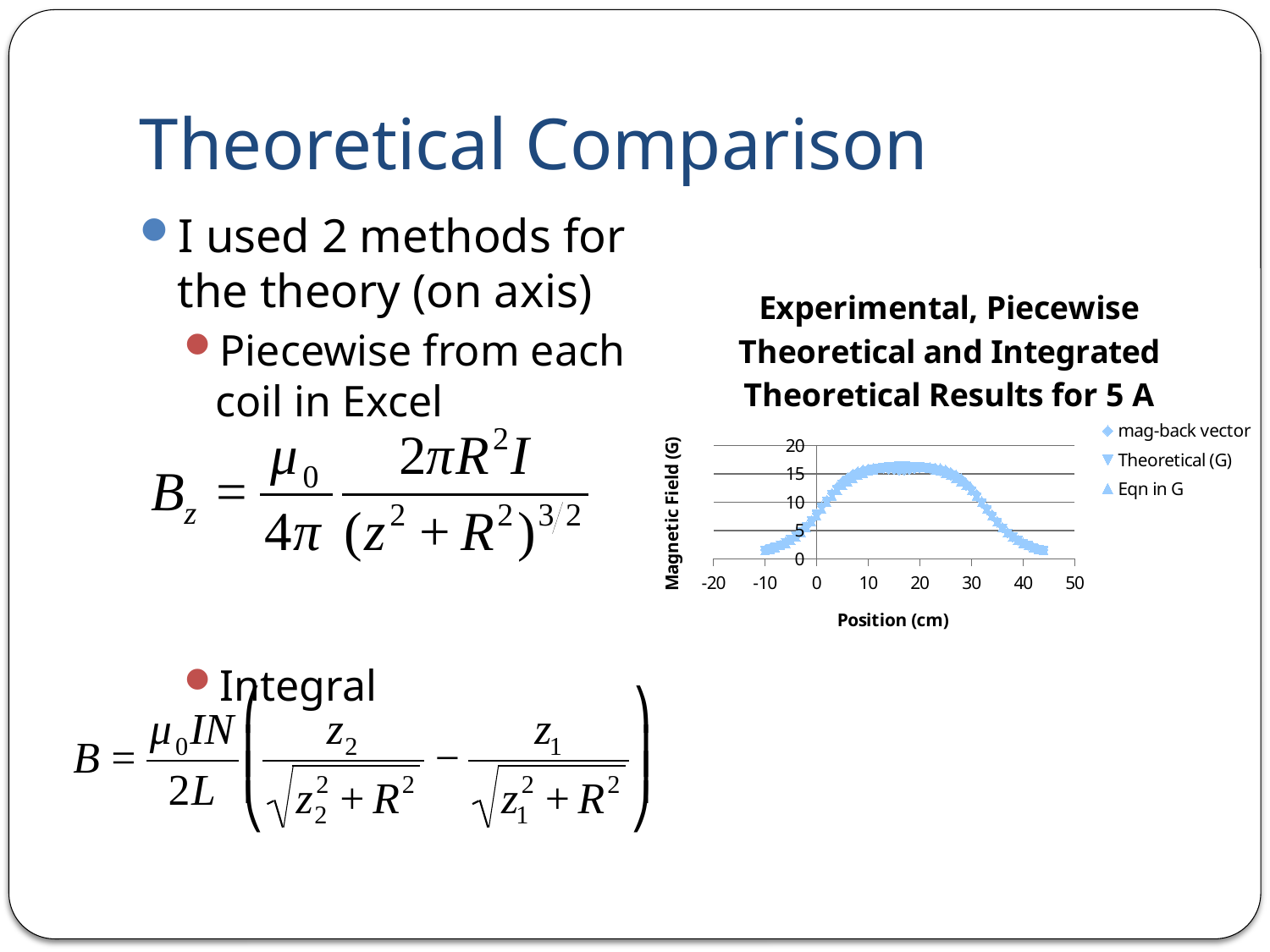
Is the magnetic field at a position of -10 cm greater or less than 5? less Which is larger, the magnetic field at 15 cm or at 40 cm? 15 cm Does the magnetic field rise or fall as position increases from 0 cm to 10 cm? rises What is the title of the chart? Experimental, Piecewise Theoretical and Integrated Theoretical Results for 5 A How many series does the chart's legend list? 3 What is the label of the chart's x axis? Position (cm) Is the peak magnetic field shown on the chart greater or less than 20? less Is the magnetic field at a position of 40 cm greater or less than 5? less Does the magnetic field rise or fall as position increases from 30 cm to 40 cm? falls What kind of chart is shown on the slide? scatter chart